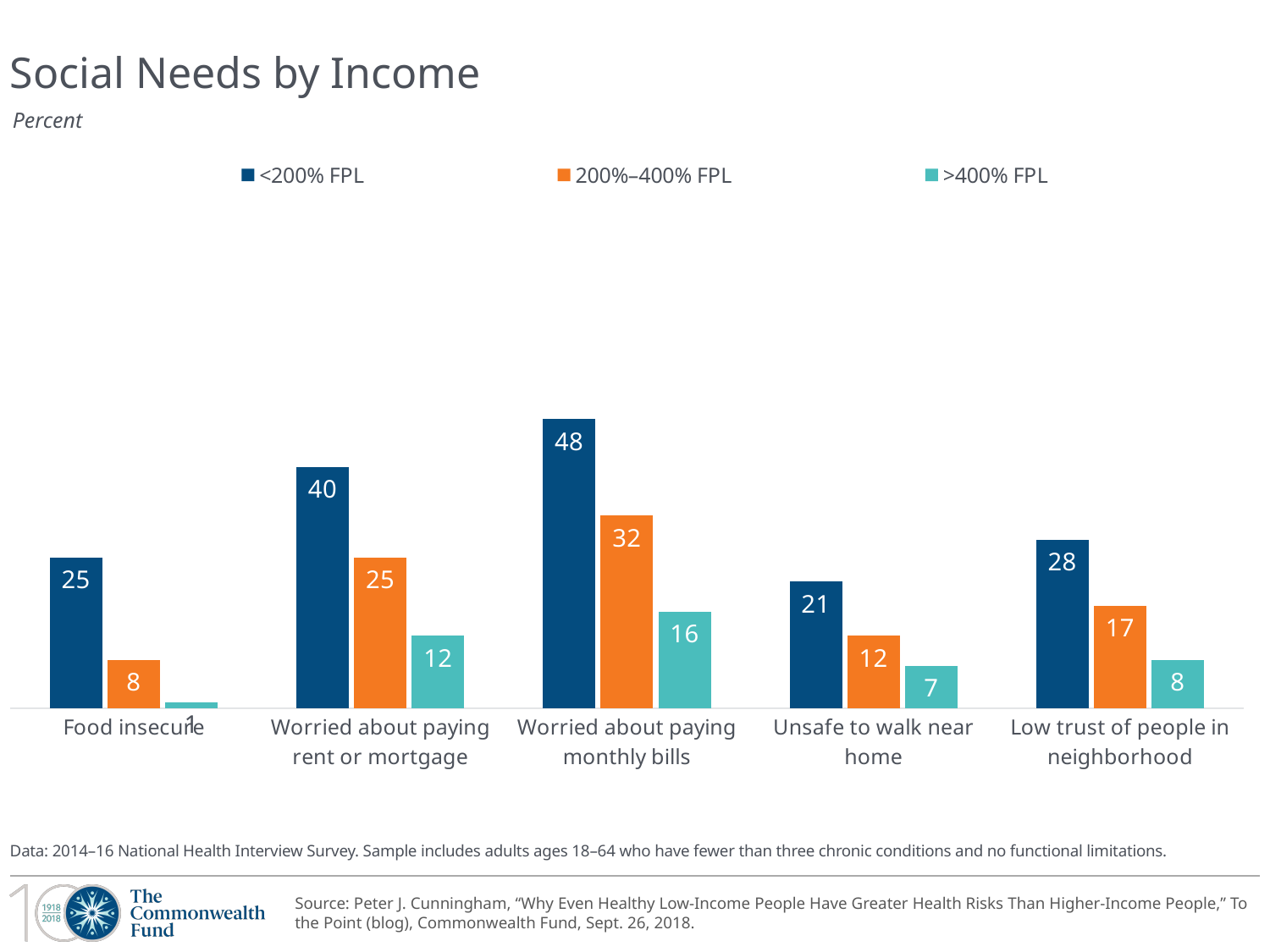
How many series does the legend list? 3 What is the value for >400% FPL in the 'Unsafe to walk near home' category? 7 Which category has the highest value for the <200% FPL series? Worried about paying monthly bills What is the value for 200%–400% FPL in the 'Low trust of people in neighborhood' category? 17 How many categories are shown on the x axis? 5 Which series is shown in orange? 200%–400% FPL Which category has the lowest value for the >400% FPL series? Food insecure What is the value for <200% FPL in the 'Worried about paying monthly bills' category? 48 What is the difference between the <200% FPL and >400% FPL values for 'Worried about paying rent or mortgage'? 28 What is the title of the chart? Social Needs by Income Which is larger: the 200%–400% FPL value for 'Worried about paying monthly bills' or the <200% FPL value for 'Low trust of people in neighborhood'? 200%–400% FPL value for 'Worried about paying monthly bills' What kind of chart is shown on the slide? Bar chart